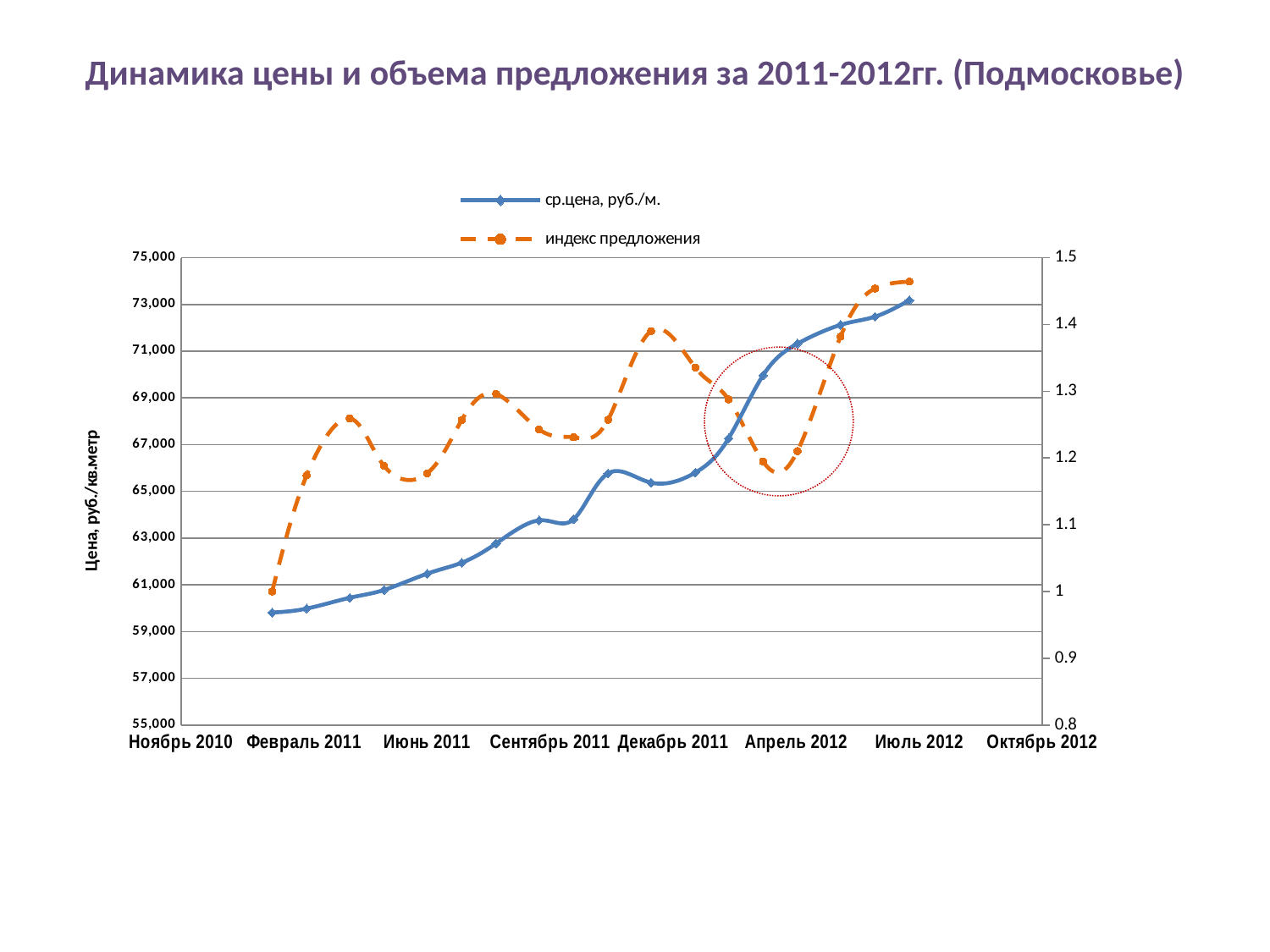
Is the value of 'ср.цена, руб./м.' at Июль 2012 greater or less than 71,000? greater At which x-axis date does the series 'индекс предложения' have its lowest value? Февраль 2011 Does the series 'ср.цена, руб./м.' rise or fall overall from Февраль 2011 to Июль 2012? rise What is the title of the chart? Динамика цены и объема предложения за 2011-2012гг. (Подмосковье) Is the value of 'ср.цена, руб./м.' at Декабрь 2011 greater or less than 67,000? less What kind of chart is shown on the slide? line chart Is the value of 'ср.цена, руб./м.' at Февраль 2011 greater or less than 61,000? less How many series does the legend list? 2 At which x-axis date does the series 'ср.цена, руб./м.' reach its highest value? Июль 2012 What is the label of the left vertical axis? Цена, руб./кв.метр